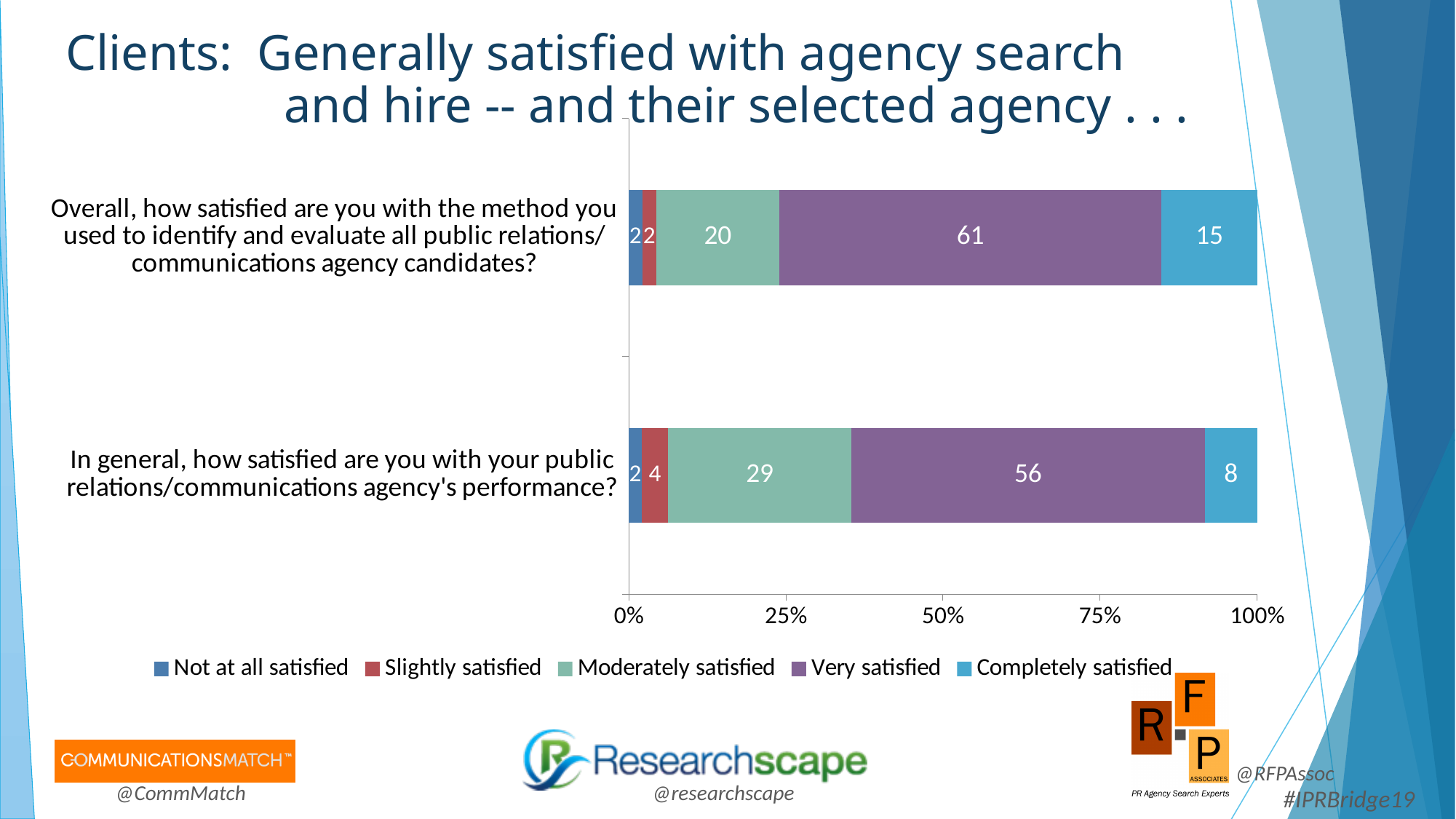
What is the total of the stacked bar for the question about the agency's performance? 99 What kind of chart is shown on the slide? Stacked bar chart What is the 'Moderately satisfied' value for the question about the agency's performance? 29 What is the difference between the 'Very satisfied' values for the two questions? 5 Which question has the larger 'Completely satisfied' value: the one about the search method or the one about the agency's performance? The one about the search method Which legend entry is shown in purple? Very satisfied What is the 'Slightly satisfied' value for the question about the agency's performance? 4 What is the 'Very satisfied' value for the question about the method used to identify and evaluate agency candidates? 61 What is the 'Completely satisfied' value for the question about the agency's performance? 8 Which satisfaction level has the largest share for the question about the method used to identify and evaluate agency candidates? Very satisfied How many series does the legend list? 5 How many survey questions (categories) are plotted in the chart? 2